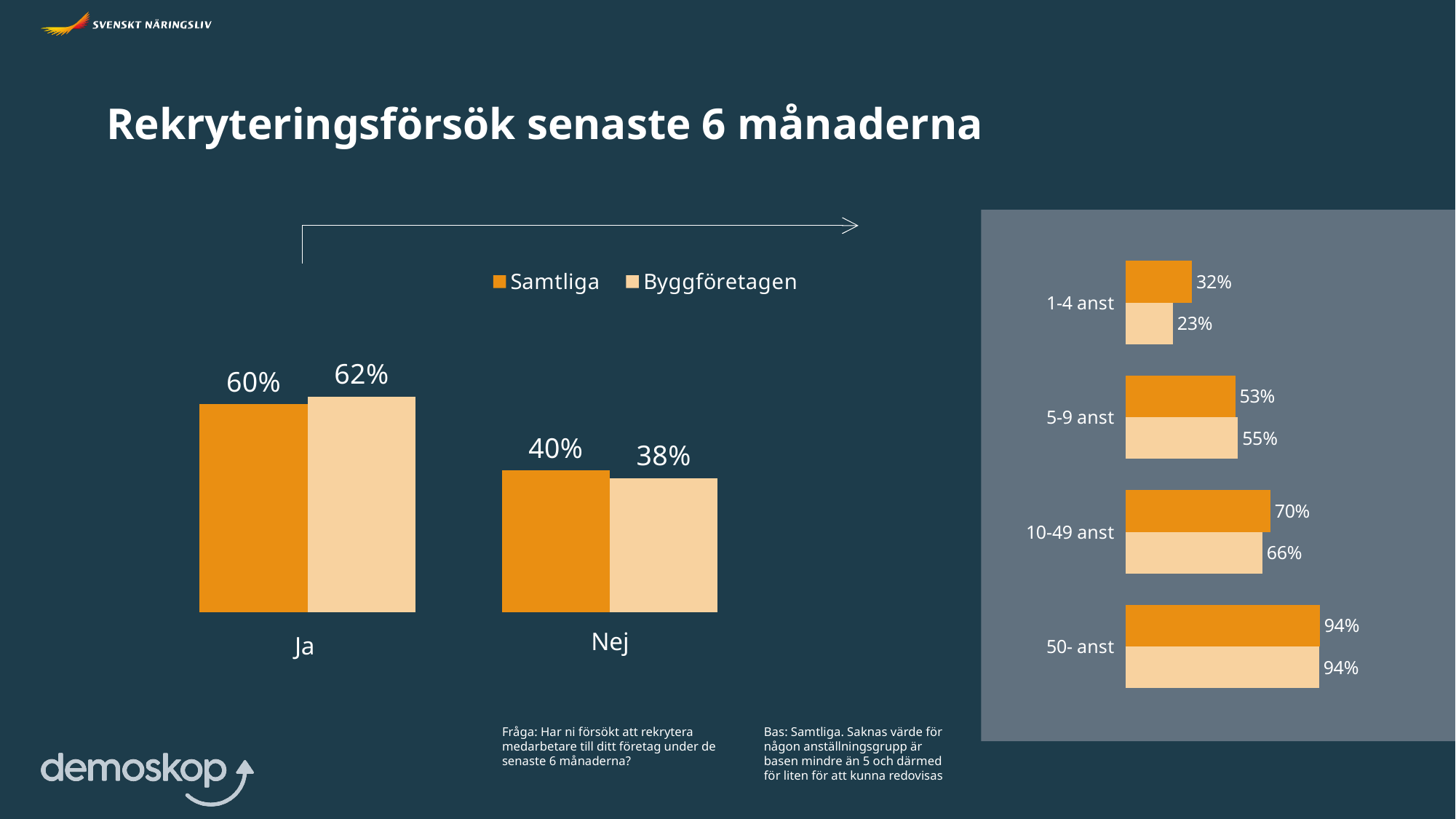
On the right chart, what is the value of the orange bar for 1-4 anst? 32% On the right chart, which category has the lowest light bar value? 1-4 anst On the right chart, which category has the highest orange bar value? 50- anst What kind of chart is the left chart? Bar chart On the left chart, what is the value for Byggföretagen in the Nej category? 38% On the right chart, what is the value of the light bar for 10-49 anst? 66% On the left chart, what is the difference between the Samtliga and Byggföretagen values for Ja? 2 percentage points On the right chart, what is the difference between the orange and light bar values for 1-4 anst? 9 percentage points On the left chart, what is the value for Samtliga in the Ja category? 60% On the left chart, which is larger for Nej: Samtliga or Byggföretagen? Samtliga How many categories are shown on the right chart? 4 How many series does the legend on the left chart list? 2